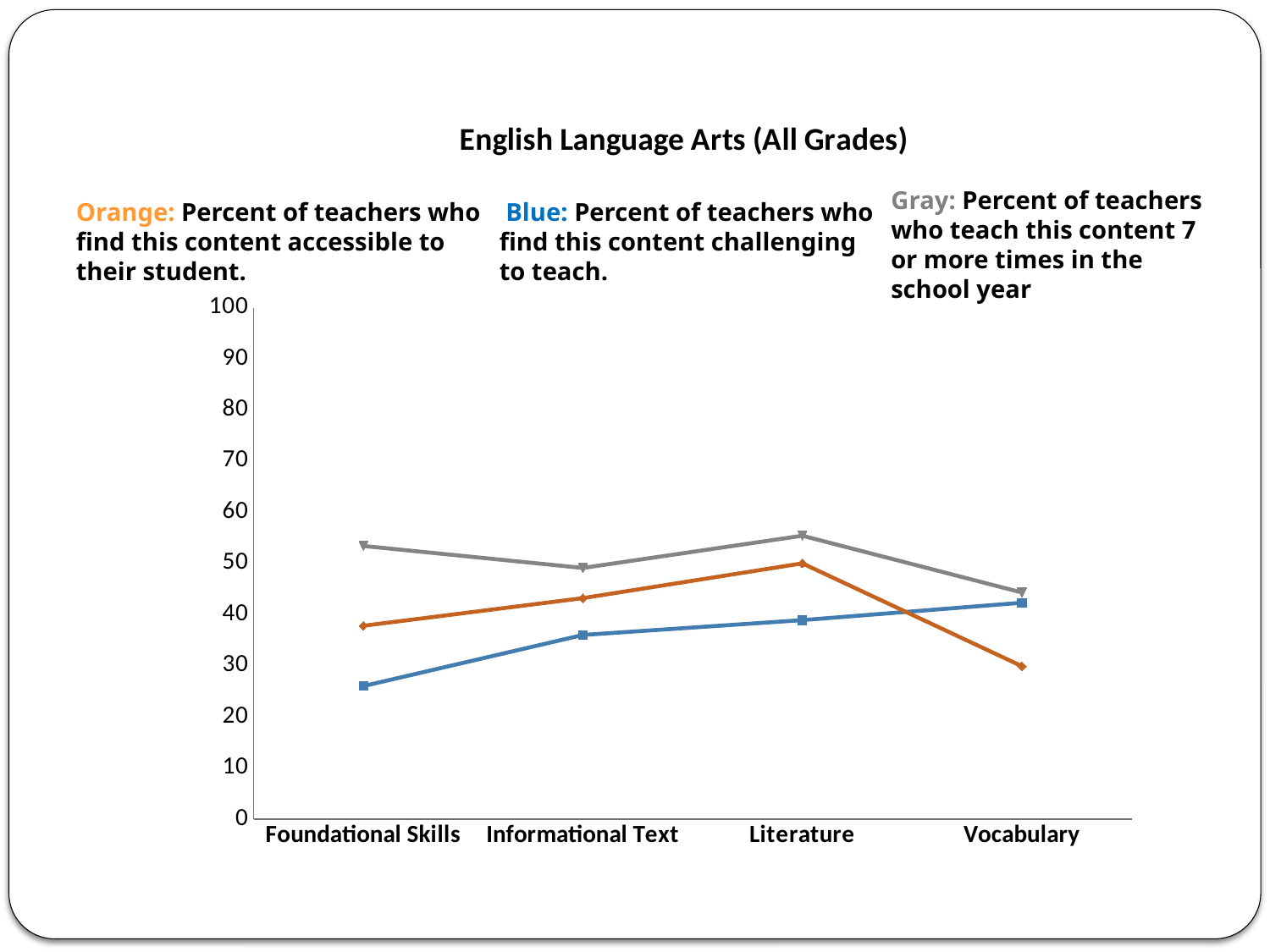
For which category is the orange (accessible) series highest? Literature What is the title of the chart? English Language Arts (All Grades) Is the blue (challenging to teach) value for Foundational Skills greater or less than 30? less Is the orange (accessible) value for Vocabulary greater or less than 40? less For which category is the orange (accessible) series lowest? Vocabulary How many categories are shown on the x axis? 4 At Vocabulary, which is larger: the blue (challenging to teach) value or the orange (accessible) value? blue Is the gray (taught 7 or more times) value for Literature greater or less than 50? greater For which category is the blue (challenging to teach) series lowest? Foundational Skills How many series are plotted on the chart? 3 What kind of chart is shown on the slide? line chart Does the blue (challenging to teach) series rise or fall from Foundational Skills to Vocabulary? rise